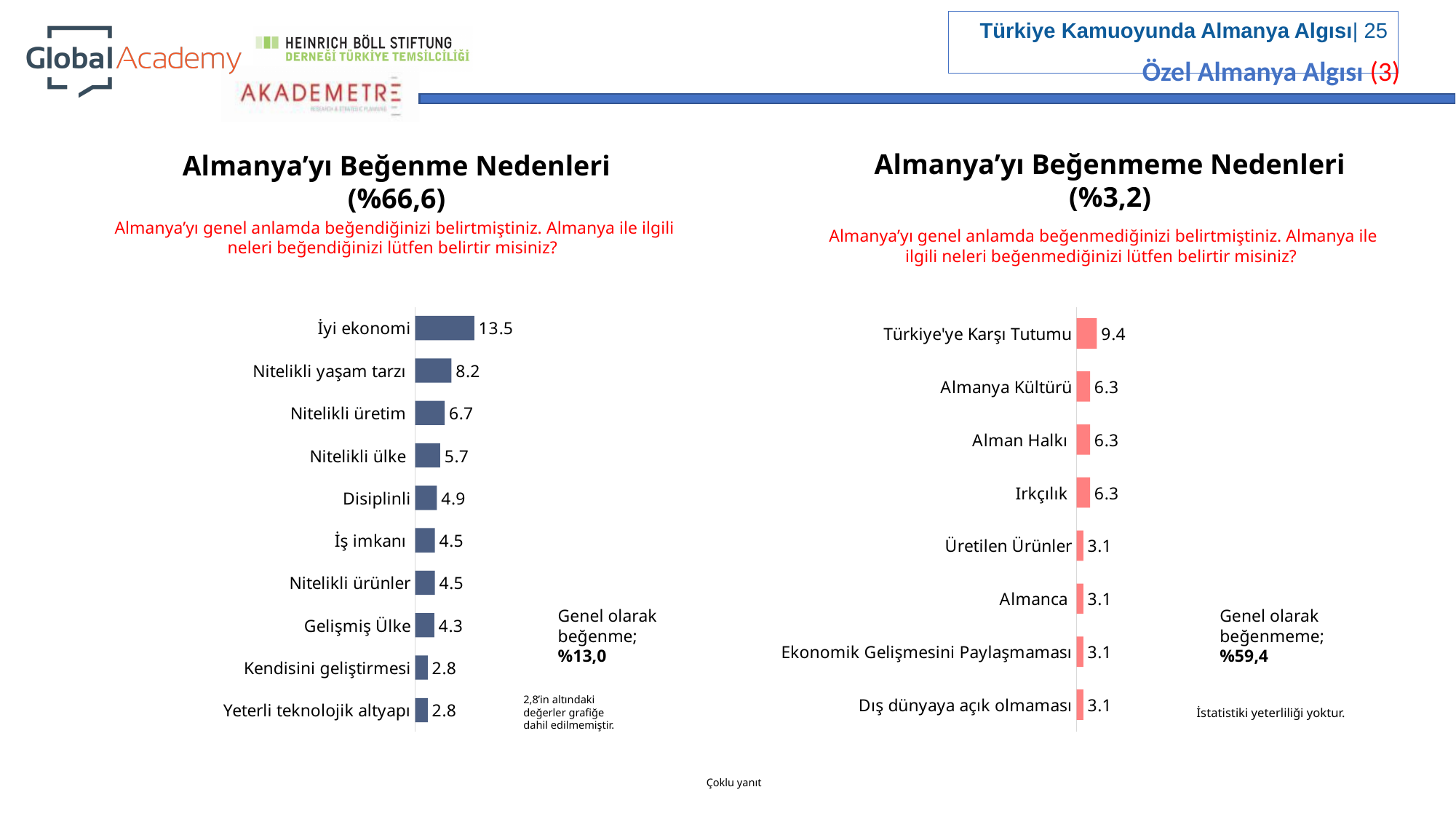
In the 'Almanya'yı Beğenme Nedenleri' chart, what is the difference between İyi ekonomi and Nitelikli yaşam tarzı? 5.3 In the 'Almanya'yı Beğenme Nedenleri' chart, which category has the highest value? İyi ekonomi In the 'Almanya'yı Beğenmeme Nedenleri' chart, what is the difference between Türkiye'ye Karşı Tutumu and Almanya Kültürü? 3.1 What type of chart is the 'Almanya'yı Beğenme Nedenleri' chart? Bar chart In the 'Almanya'yı Beğenmeme Nedenleri' chart, how many categories are shown? 8 In the 'Almanya'yı Beğenmeme Nedenleri' chart, what is the value for Almanca? 3.1 In the 'Almanya'yı Beğenme Nedenleri' chart, how many categories are shown? 10 In the 'Almanya'yı Beğenmeme Nedenleri' chart, what is the value for Türkiye'ye Karşı Tutumu? 9.4 In the 'Almanya'yı Beğenmeme Nedenleri' chart, which is larger: Irkçılık or Üretilen Ürünler? Irkçılık In the 'Almanya'yı Beğenmeme Nedenleri' chart, which category has the highest value? Türkiye'ye Karşı Tutumu In the 'Almanya'yı Beğenme Nedenleri' chart, what is the value for İyi ekonomi? 13.5 In the 'Almanya'yı Beğenme Nedenleri' chart, what is the value for Nitelikli üretim? 6.7